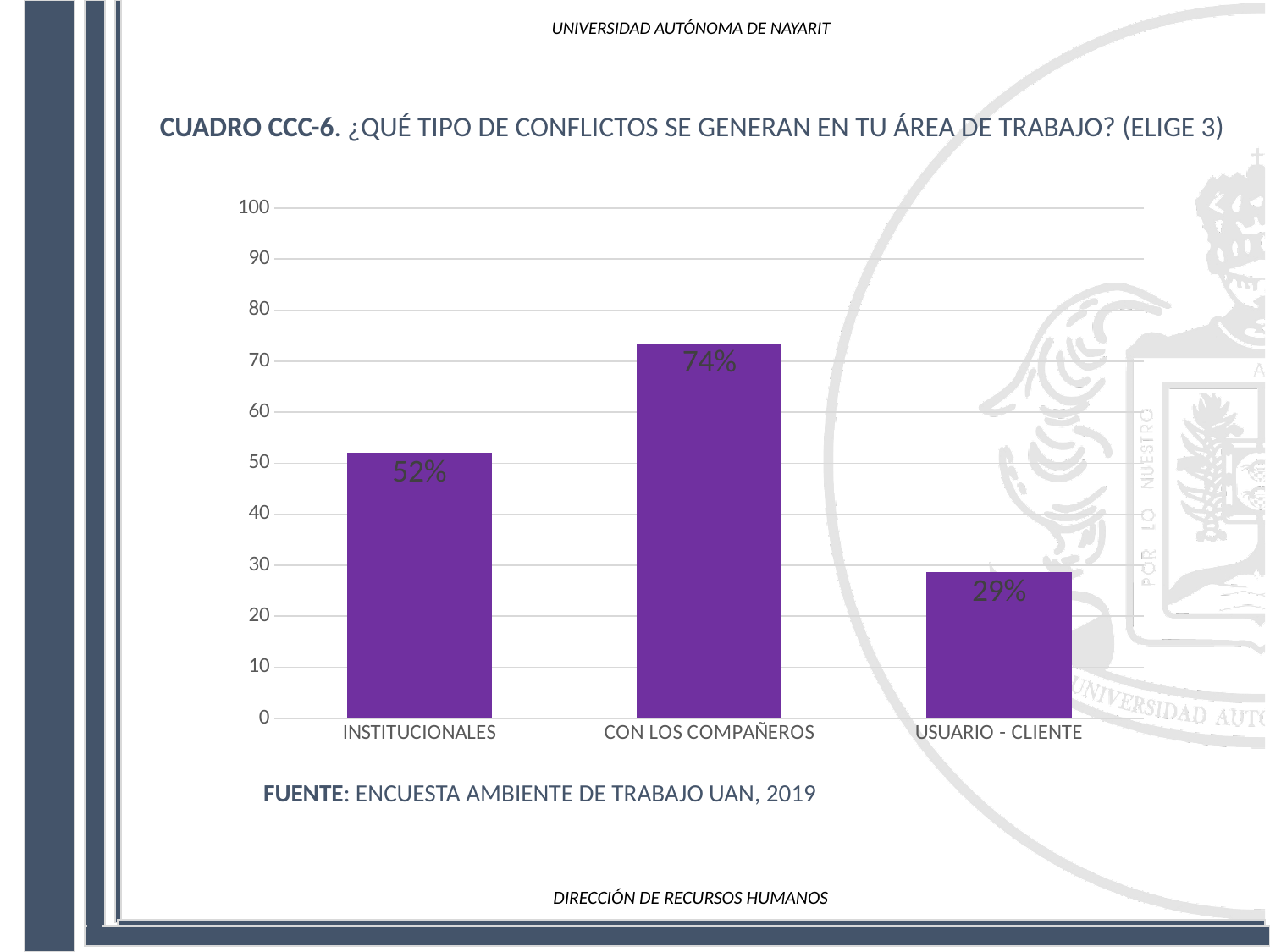
Which category has the lowest value? USUARIO - CLIENTE What is the difference between the values for CON LOS COMPAÑEROS and INSTITUCIONALES? 22% Which is larger, the value for INSTITUCIONALES or the value for USUARIO - CLIENTE? INSTITUCIONALES What is the value for INSTITUCIONALES? 52% Which category has the highest value? CON LOS COMPAÑEROS What is the difference between the values for INSTITUCIONALES and USUARIO - CLIENTE? 23% How many categories are shown on the x axis? 3 What kind of chart is shown on the slide? bar chart What is the value for CON LOS COMPAÑEROS? 74% Is the value for CON LOS COMPAÑEROS greater or less than 70? greater What is the value for USUARIO - CLIENTE? 29% What source is cited below the chart? ENCUESTA AMBIENTE DE TRABAJO UAN, 2019